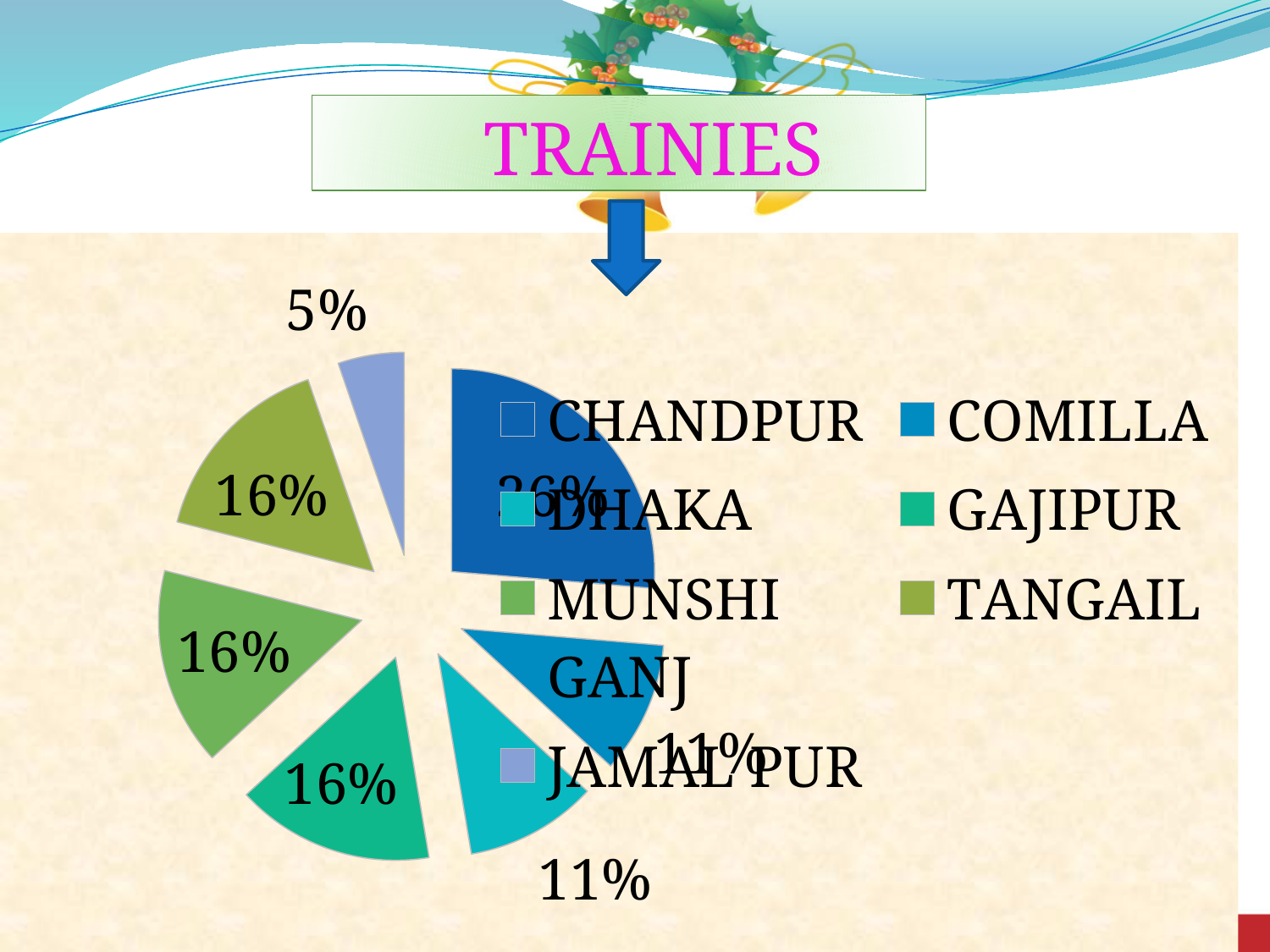
What share of the pie does GAJIPUR have? 16% Which category has the smallest slice of the pie? JAMALPUR What share of the pie does JAMALPUR have? 5% What share of the pie does DHAKA have? 11% Which category has the largest slice of the pie? CHANDPUR How many categories does the legend of the pie chart list? 7 What is the title shown above the chart? TRAINIES What share of the pie does TANGAIL have? 16% Which has a larger share, TANGAIL or COMILLA? TANGAIL What share of the pie does COMILLA have? 11% By how many percentage points does GAJIPUR's share exceed JAMALPUR's share? 11% What kind of chart is shown on the slide? pie chart